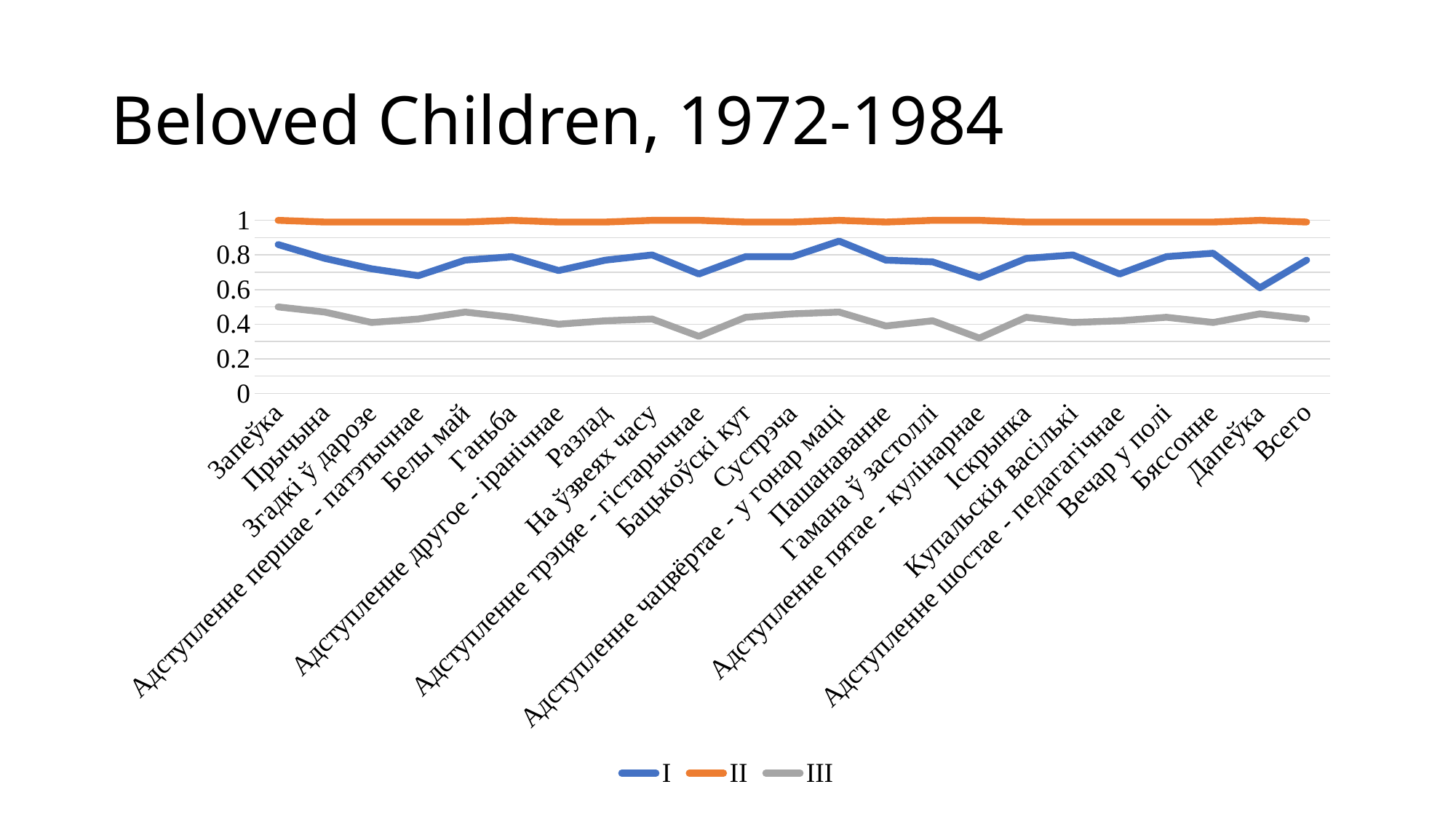
Is the value of series III for Адступленне трэцяе - гістарычнае greater or less than 0.4? less What is the title of the slide containing the chart? Beloved Children, 1972-1984 How many categories are plotted along the x axis? 23 For series I, which category has the lowest value? Дапеўка Is the value of series I for Адступленне першае - патэтычнае greater or less than 0.8? less Is the value of series I for Адступленне чацвёртае - у гонар маці greater or less than 0.8? greater How many series does the legend list? 3 Which series has the highest values across all categories? II At Запеўка, which series has the larger value, I or III? I What are the names of the series in the legend? I, II, III Does series I rise or fall from Бяссонне to Дапеўка? fall What kind of chart is shown on the slide? line chart